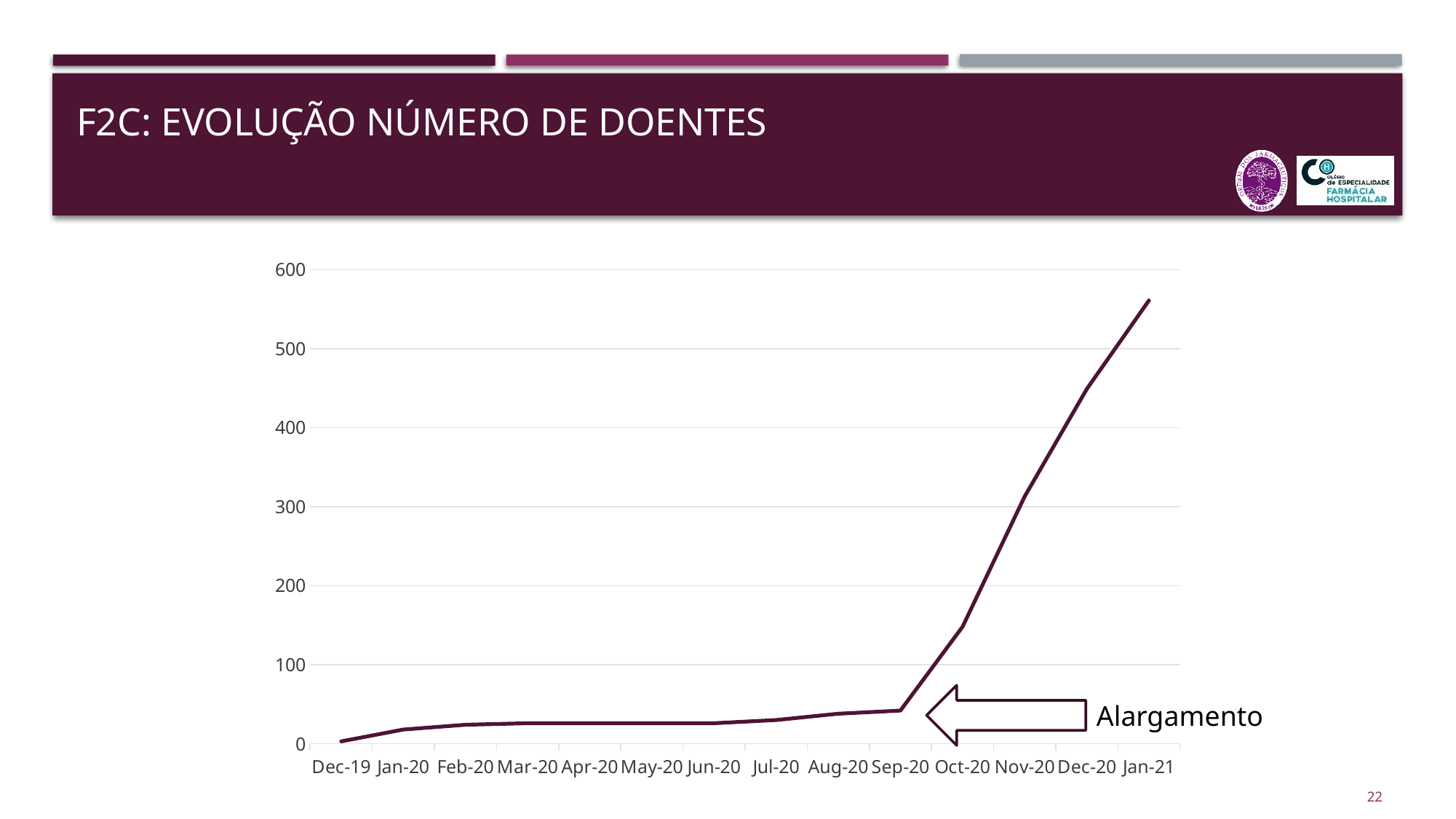
Which is larger, the value for Dec-20 or the value for Jan-21? Jan-21 Is the value for Nov-20 greater or less than 400? less How many monthly points are plotted along the x axis? 14 Which month has the highest value? Jan-21 Is the value for Dec-20 greater or less than 500? less Is the value for Sep-20 greater or less than 100? less Which month has the lowest value? Dec-19 Do the values generally rise or fall from Dec-19 to Jan-21? rise What word is written next to the arrow pointing at the chart? Alargamento What kind of chart is shown on the slide? line chart